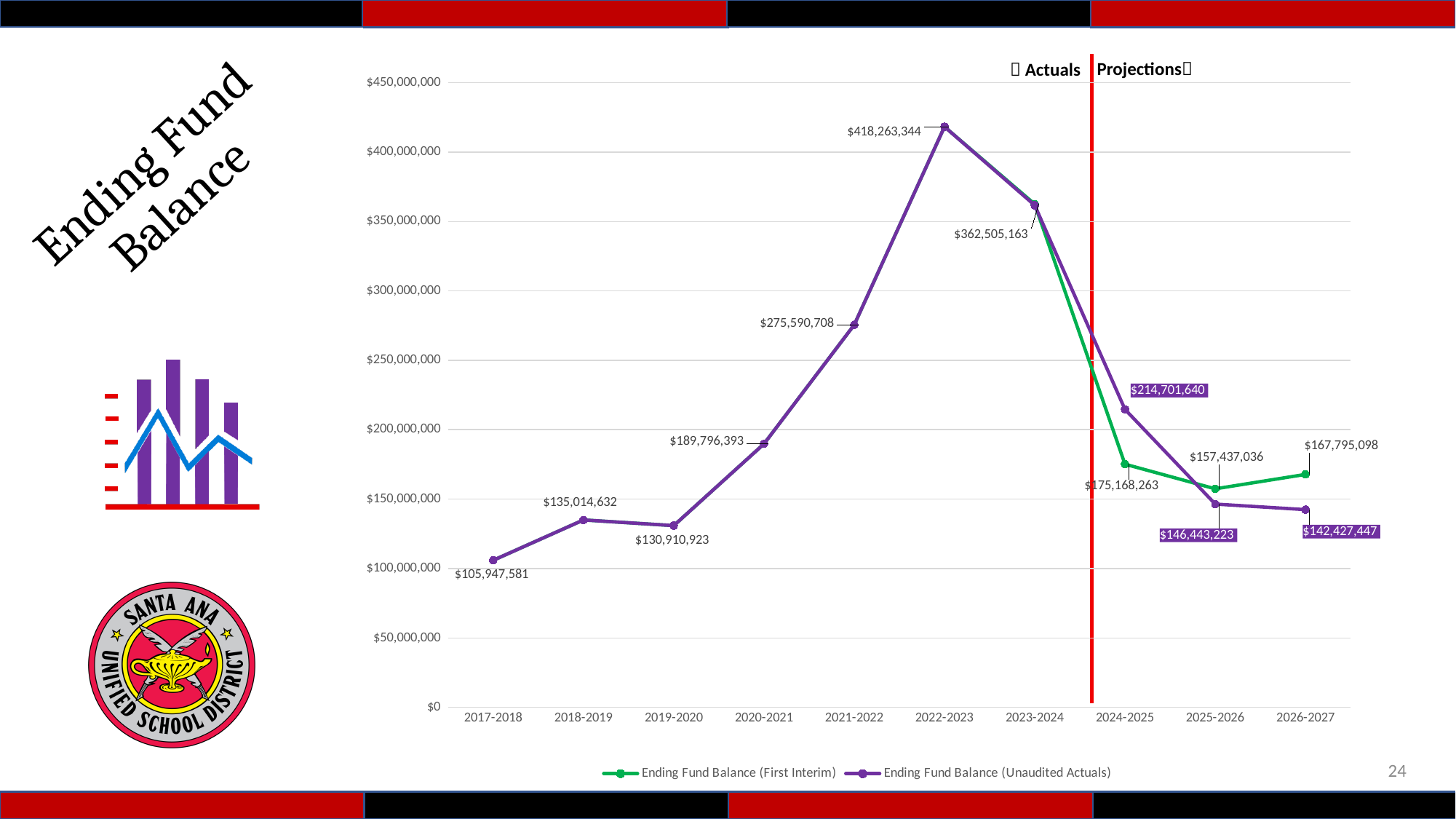
Which fiscal year has the highest ending fund balance? 2022-2023 What is the difference between the 2022-2023 and 2023-2024 ending fund balances? $55,758,181 What is the Ending Fund Balance (First Interim) value for 2026-2027? $167,795,098 Do the ending fund balance values rise or fall from 2017-2018 to 2022-2023? rise What type of chart is shown on the slide? line chart How many series does the legend list? 2 Is the ending fund balance for 2021-2022 greater or less than $250,000,000? greater Which fiscal year has the lowest ending fund balance? 2017-2018 What is the ending fund balance for 2022-2023? $418,263,344 What is the Ending Fund Balance (Unaudited Actuals) value for 2024-2025? $214,701,640 For 2025-2026, which series is larger: Ending Fund Balance (First Interim) or Ending Fund Balance (Unaudited Actuals)? Ending Fund Balance (First Interim) How many fiscal years are shown on the x axis? 10